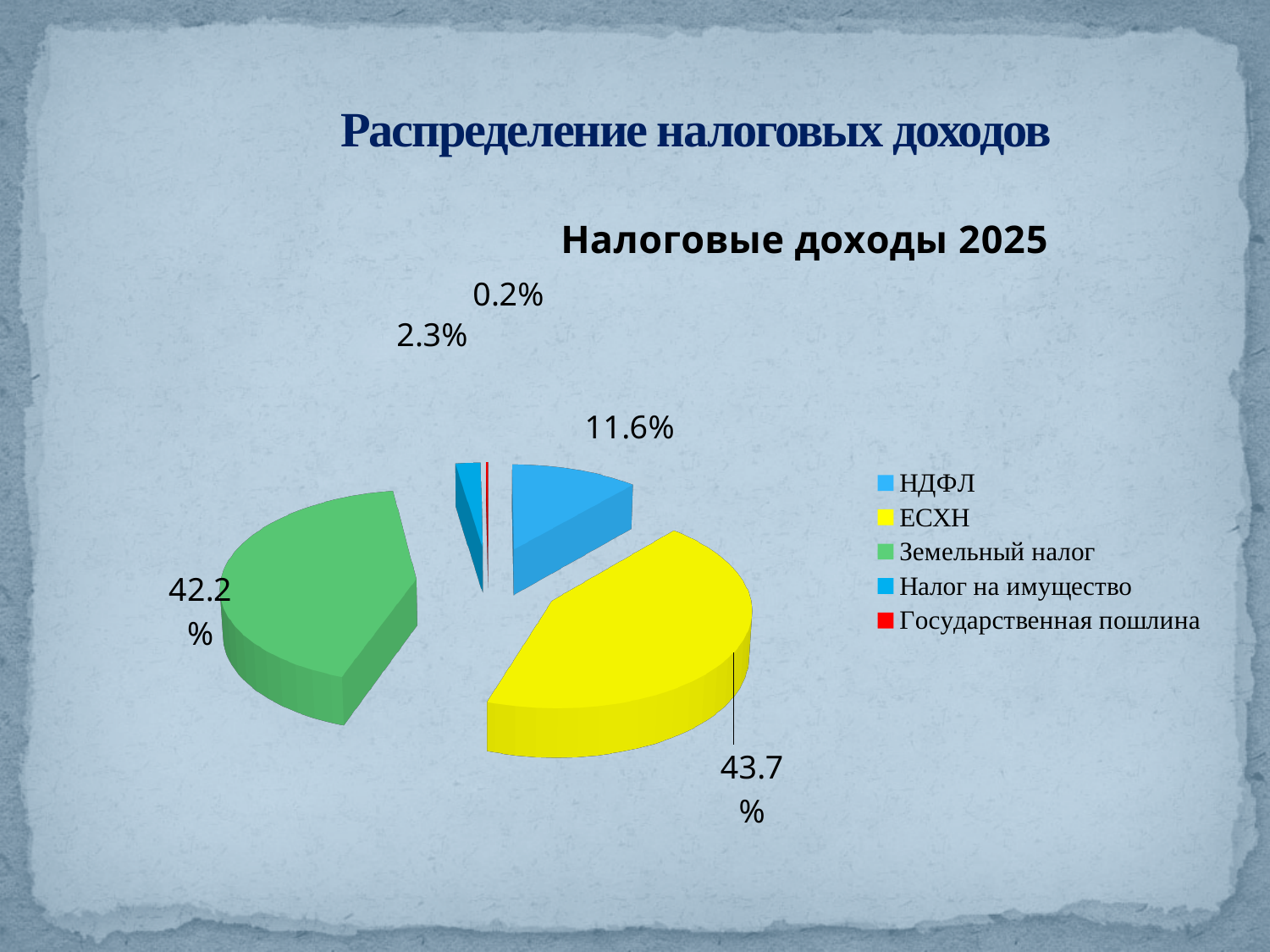
What share of the pie does Государственная пошлина have? 0.2% What share of the pie does Налог на имущество have? 2.3% Which category has the smallest share of the pie? Государственная пошлина What share of the pie does Земельный налог have? 42.2% What is the difference between the shares of ЕСХН and Земельный налог? 1.5% What is the title of the chart? Налоговые доходы 2025 How many categories does the legend of the chart list? 5 What share of the pie does НДФЛ have? 11.6% Which is larger, the share of НДФЛ or the share of Налог на имущество? НДФЛ Which category has the largest share of the pie? ЕСХН What type of chart is shown on the slide? pie chart What share of the pie does ЕСХН have? 43.7%